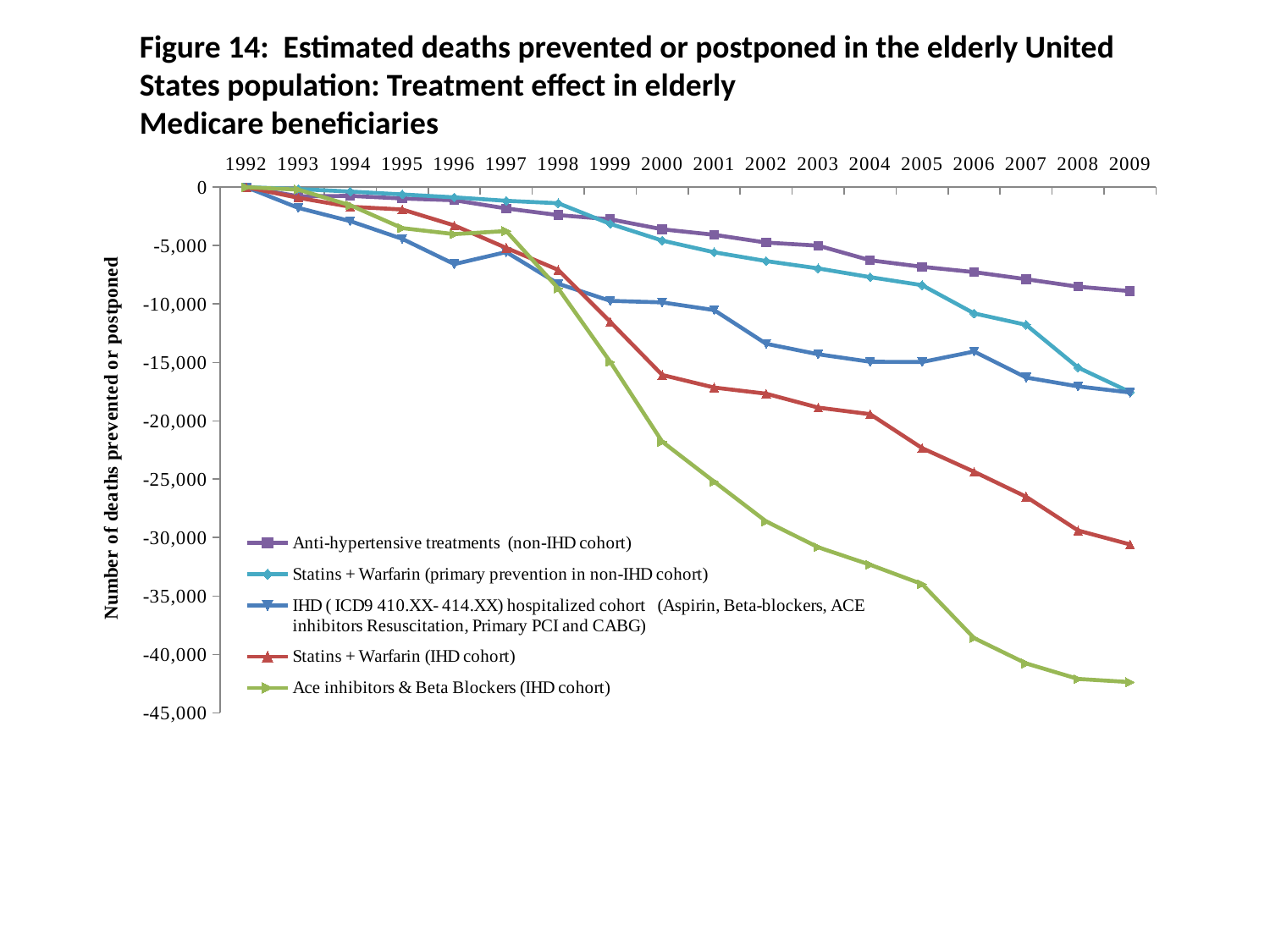
How many years are shown along the x axis? 18 What is the value for Anti-hypertensive treatments (non-IHD cohort) in 1992? 0 Is the value for Statins + Warfarin (IHD cohort) in 2005 greater or less than -20,000? less What kind of chart is shown on the slide? line chart How many series does the legend list? 5 Which series has the highest value in 2009? Anti-hypertensive treatments (non-IHD cohort) Is the value for Ace inhibitors & Beta Blockers (IHD cohort) in 2009 greater or less than -40,000? less What is the first year shown on the x axis? 1992 Which series has the lowest value in 2009? Ace inhibitors & Beta Blockers (IHD cohort) In 2005, which is larger: the value for Anti-hypertensive treatments (non-IHD cohort) or the value for Statins + Warfarin (IHD cohort)? Anti-hypertensive treatments (non-IHD cohort) Is the value for Anti-hypertensive treatments (non-IHD cohort) in 2009 greater or less than -10,000? greater Do the values for Ace inhibitors & Beta Blockers (IHD cohort) rise or fall from 1992 to 2009? fall